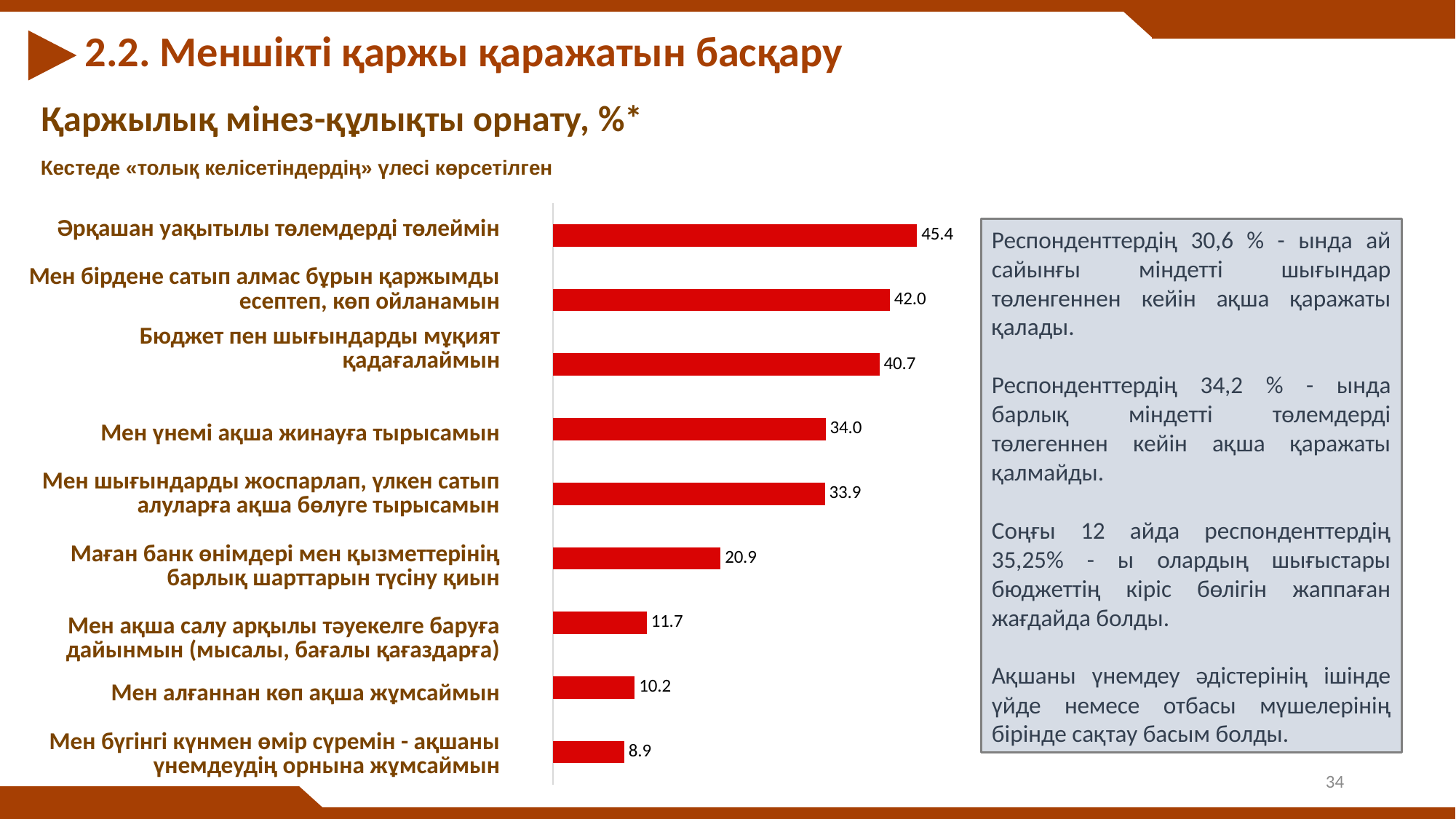
Which is larger: the value for "Мен үнемі ақша жинауға тырысамын" or the value for "Маған банк өнімдері мен қызметтерінің барлық шарттарын түсіну қиын"? Мен үнемі ақша жинауға тырысамын What is the title of the chart? Қаржылық мінез-құлықты орнату, %* What is the value for "Бюджет пен шығындарды мұқият қадағалаймын"? 40.7 Which category has the highest value? Әрқашан уақытылы төлемдерді төлеймін What is the value for "Мен алғаннан көп ақша жұмсаймын"? 10.2 What is the value for "Әрқашан уақытылы төлемдерді төлеймін"? 45.4 What is the value for "Маған банк өнімдері мен қызметтерінің барлық шарттарын түсіну қиын"? 20.9 What is the difference between the values for "Әрқашан уақытылы төлемдерді төлеймін" and "Мен бірдене сатып алмас бұрын қаржымды есептеп, көп ойланамын"? 3.4 Which category has the lowest value? Мен бүгінгі күнмен өмір сүремін - ақшаны үнемдеудің орнына жұмсаймын What type of chart is shown on the slide? bar chart What is the difference between the values for "Мен ақша салу арқылы тәуекелге баруға дайынмын (мысалы, бағалы қағаздарға)" and "Мен бүгінгі күнмен өмір сүремін - ақшаны үнемдеудің орнына жұмсаймын"? 2.8 How many categories are shown in the chart? 9